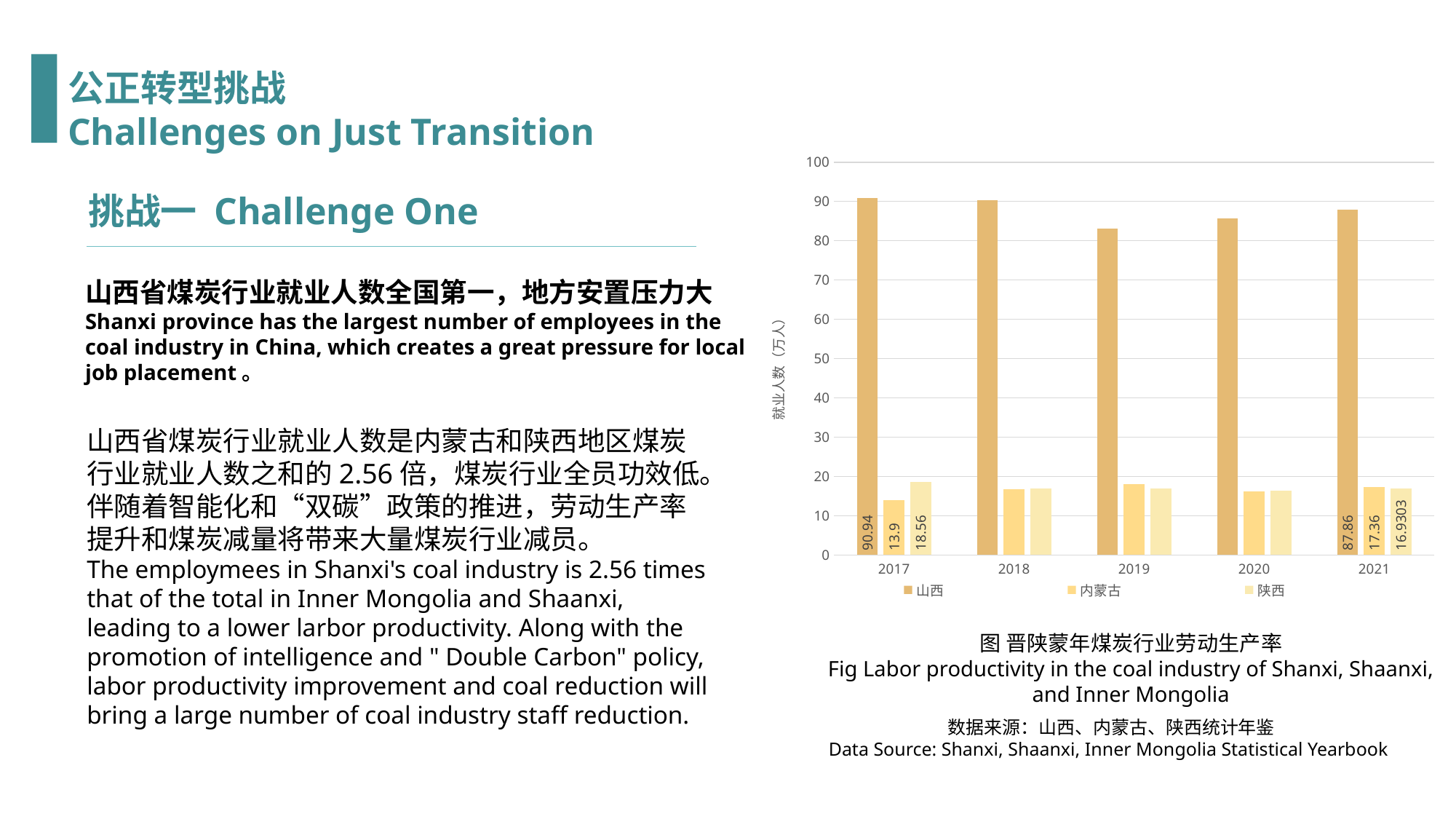
What is the value for 山西 (Shanxi) in 2017? 90.94 Which is larger in 2021, the value for 内蒙古 (Inner Mongolia) or 陕西 (Shaanxi)? 内蒙古 What is the difference between the 山西 (Shanxi) values in 2017 and 2021? 3.08 Which series has the lowest value in 2017? 内蒙古 Is the value for 山西 (Shanxi) in 2019 greater or less than 80? greater What is the value for 山西 (Shanxi) in 2021? 87.86 What is the value for 陕西 (Shaanxi) in 2021? 16.9303 How many years are shown on the x axis of the chart? 5 How many series does the chart legend list? 3 What is the value for 内蒙古 (Inner Mongolia) in 2017? 13.9 What type of chart is shown on the slide? bar chart Which series has the highest value in 2017? 山西